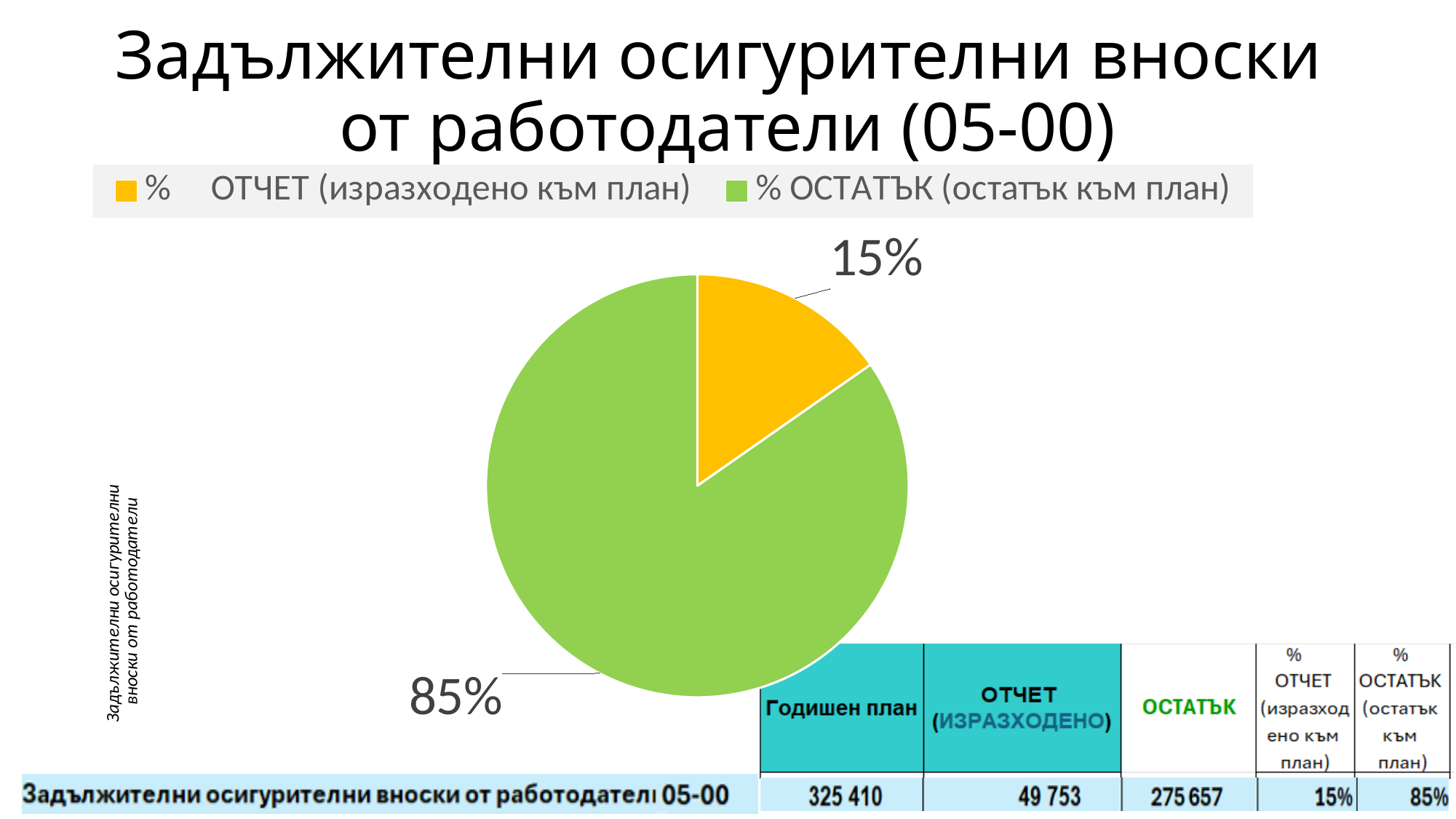
What kind of chart is shown on the slide? pie chart What share of the pie does the "% ОСТАТЪК (остатък към план)" slice represent? 85% What share of the pie does the "% ОТЧЕТ (изразходено към план)" slice represent? 15% How many entries does the legend list? 2 Which is larger, the "% ОТЧЕТ" slice or the "% ОСТАТЪК" slice? % ОСТАТЪК What is the total of the two pie slice percentages? 100% What is the difference in percentage points between the "% ОСТАТЪК" slice and the "% ОТЧЕТ" slice? 70 What colour is the "% ОТЧЕТ (изразходено към план)" slice? yellow What colour is the "% ОСТАТЪК (остатък към план)" slice? green Which slice of the pie is the smallest? % ОТЧЕТ (изразходено към план) Which slice of the pie is the largest? % ОСТАТЪК (остатък към план) How many slices does the pie chart have? 2